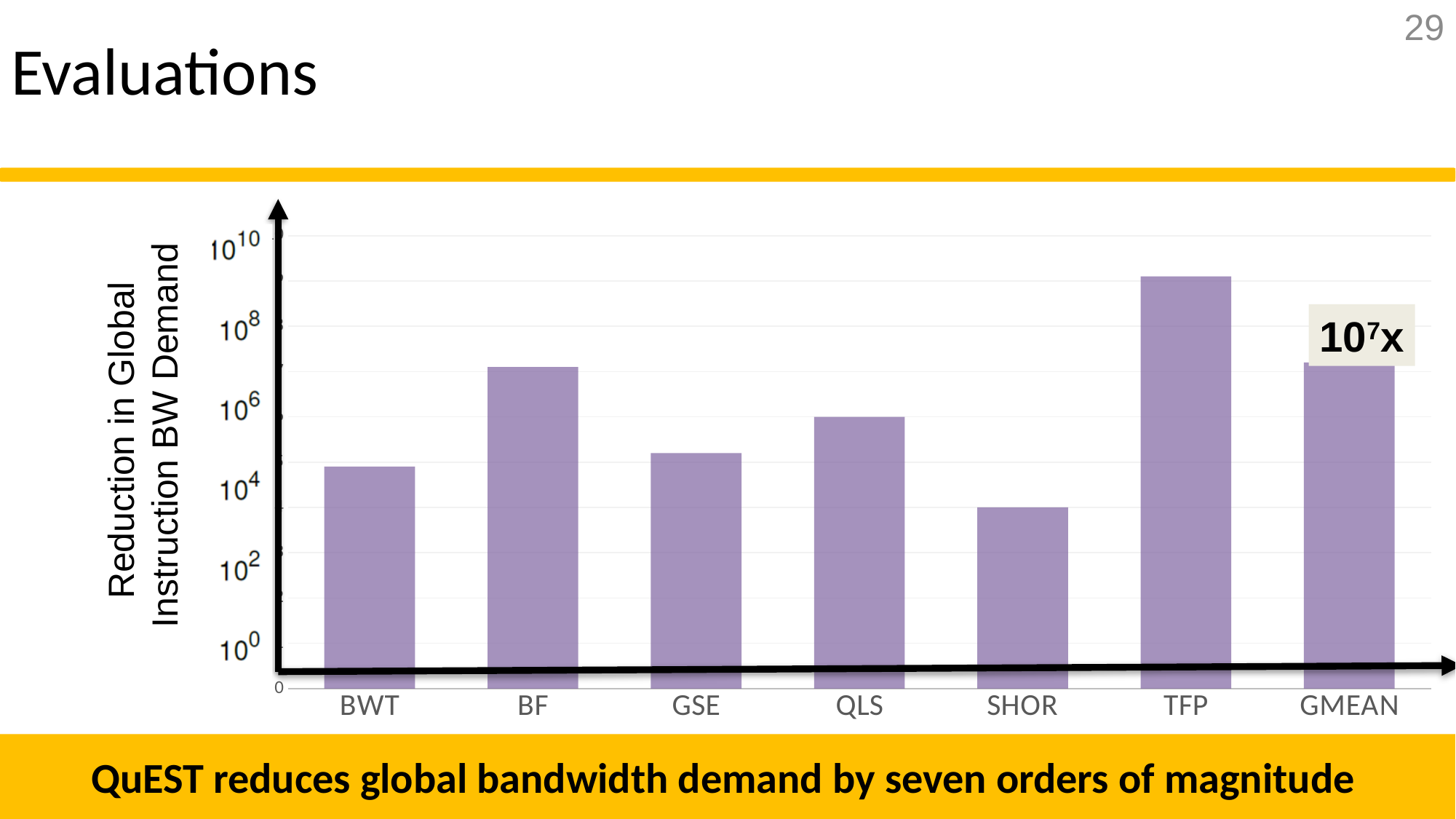
Which is larger, the value for BF or the value for GSE? BF How many categories are shown on the x axis of the chart? 7 Which category has the highest reduction in global instruction BW demand? TFP Which category has the lowest reduction in global instruction BW demand? SHOR What is the label of the y axis of the chart? Reduction in Global Instruction BW Demand Which is larger, the value for QLS or the value for SHOR? QLS What kind of chart is shown on the slide? bar chart What value is labelled on the GMEAN bar? 10⁷x Is the value for BWT greater or less than 10⁶? less Is the value for TFP greater or less than 10⁸? greater Is the value for BF greater or less than 10⁶? greater